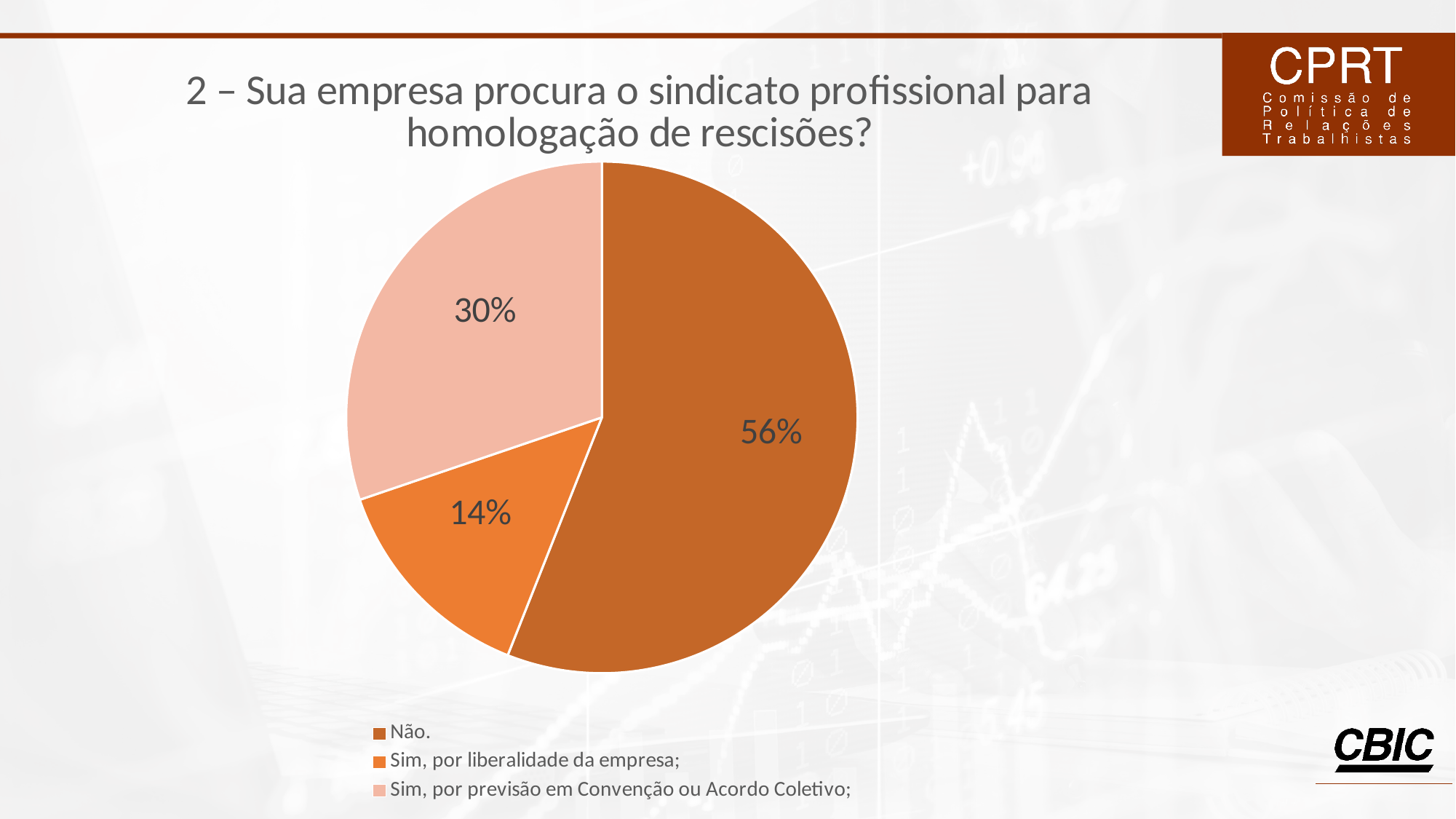
How many slices does the pie chart have? 3 What is the combined share of the two "Sim" categories? 44% How many entries does the legend list? 3 Which is larger: the share for "Sim, por liberalidade da empresa;" or the share for "Sim, por previsão em Convenção ou Acordo Coletivo;"? Sim, por previsão em Convenção ou Acordo Coletivo; What percentage of the pie corresponds to "Sim, por liberalidade da empresa;"? 14% What is the title of the chart? 2 – Sua empresa procura o sindicato profissional para homologação de rescisões? What percentage of the pie corresponds to "Sim, por previsão em Convenção ou Acordo Coletivo;"? 30% What percentage of the pie corresponds to "Não."? 56% What type of chart is shown on the slide? pie chart Which category has the smallest share of the pie? Sim, por liberalidade da empresa; Which category has the largest share of the pie? Não. What is the difference in percentage points between "Não." and "Sim, por previsão em Convenção ou Acordo Coletivo;"? 26